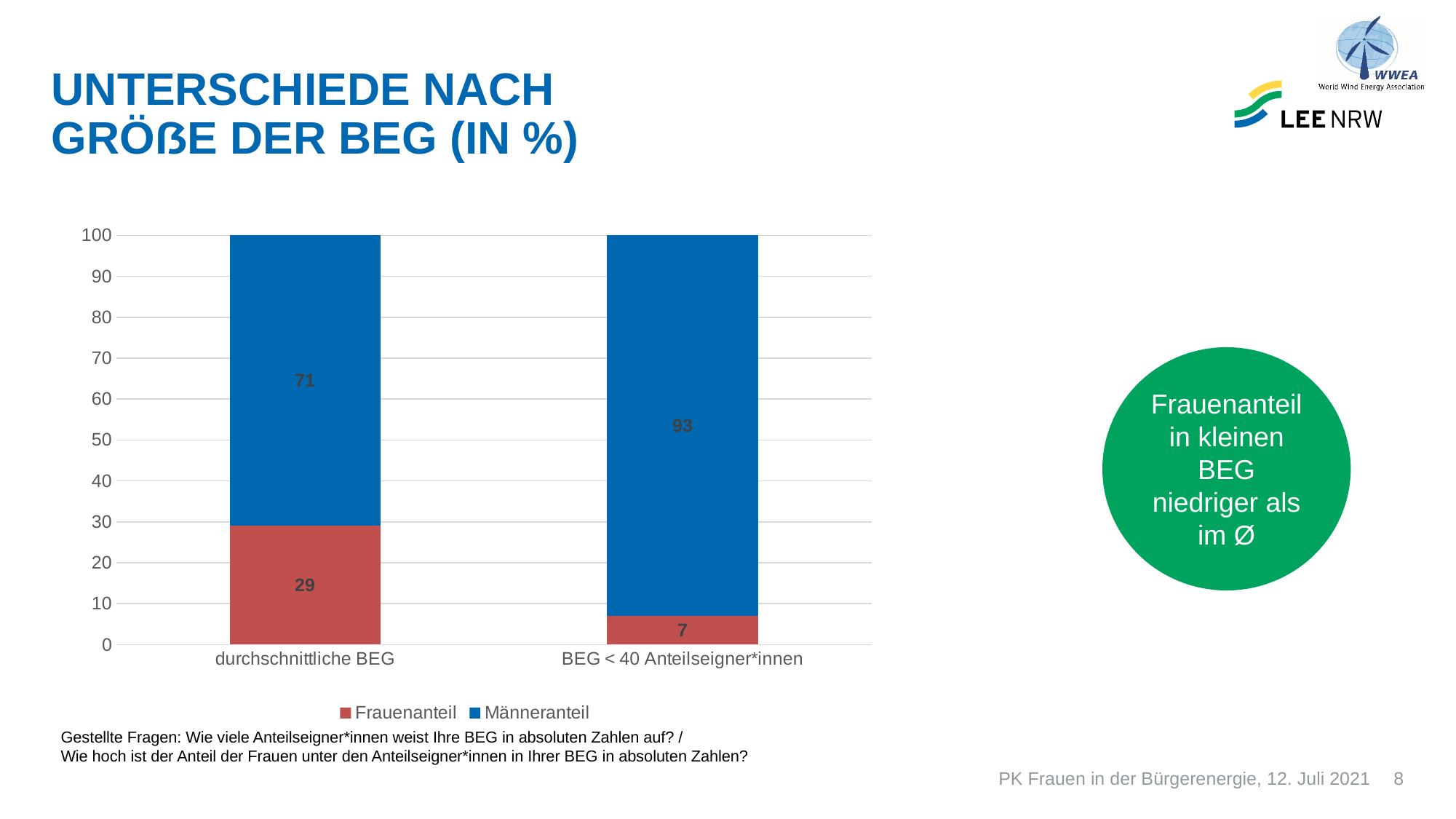
What is the Männeranteil value for BEG < 40 Anteilseigner*innen? 93 What is the Männeranteil value for durchschnittliche BEG? 71 What kind of chart is shown on the slide? Stacked bar chart What is the difference between the Frauenanteil for durchschnittliche BEG and for BEG < 40 Anteilseigner*innen? 22 What is the Frauenanteil value for BEG < 40 Anteilseigner*innen? 7 What is the total of the stacked bar for durchschnittliche BEG? 100 Which category has the highest Männeranteil? BEG < 40 Anteilseigner*innen What is the Frauenanteil value for durchschnittliche BEG? 29 Is the Frauenanteil larger for durchschnittliche BEG or for BEG < 40 Anteilseigner*innen? durchschnittliche BEG How many categories are shown on the x axis? 2 Which category has the lowest Frauenanteil? BEG < 40 Anteilseigner*innen How many series does the legend list? 2